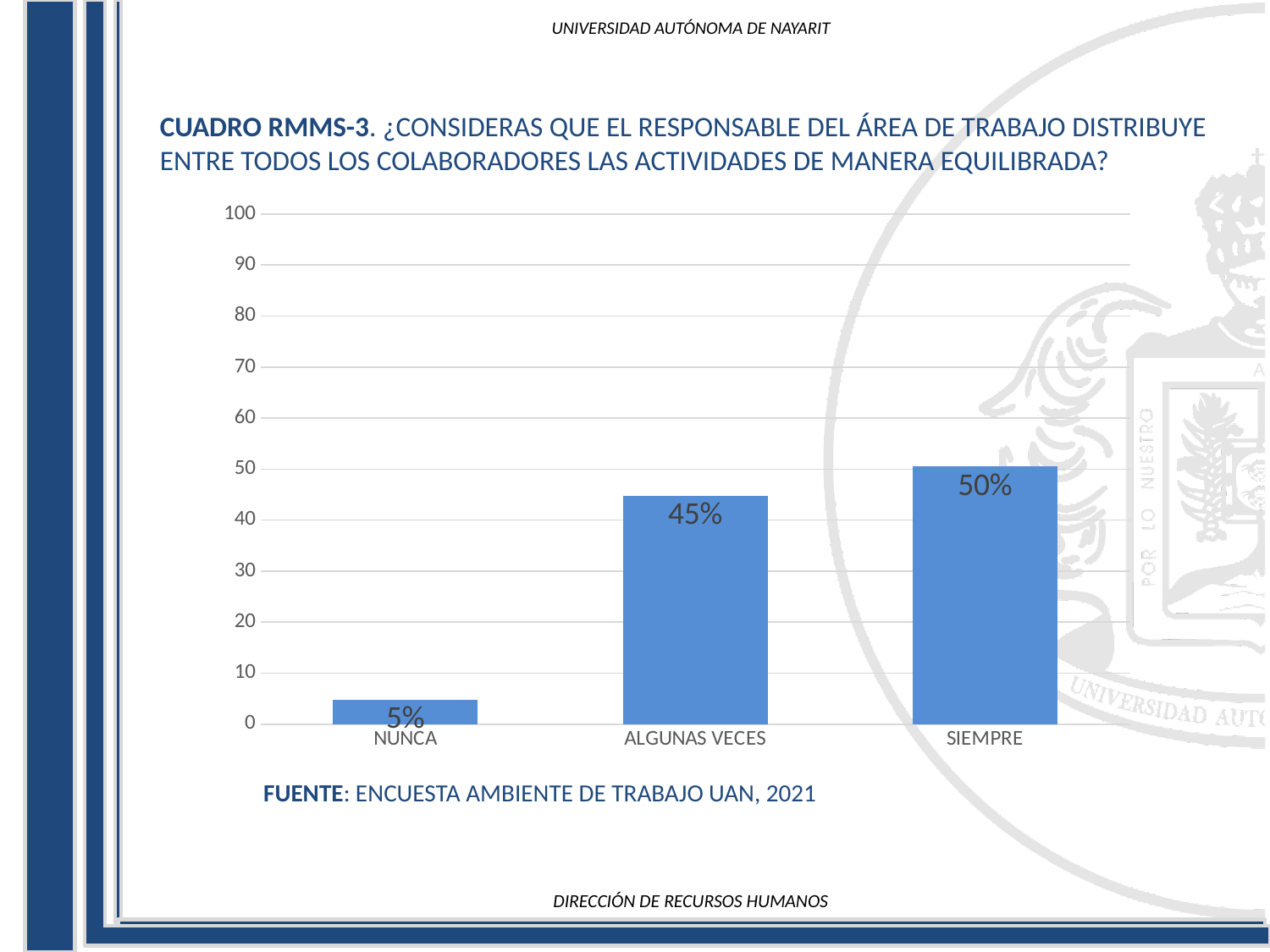
Is the value for ALGUNAS VECES greater or less than 40? greater How many categories are shown on the x axis? 3 What is the value for NUNCA? 5% What kind of chart is shown on the slide? bar chart What is the difference between the values for ALGUNAS VECES and NUNCA? 40% What is the value for SIEMPRE? 50% Which is larger, the value for NUNCA or the value for ALGUNAS VECES? ALGUNAS VECES What is the value for ALGUNAS VECES? 45% Do the values rise or fall from NUNCA to SIEMPRE along the x axis? rise Which category has the highest value? SIEMPRE Which category has the lowest value? NUNCA What is the difference between the values for SIEMPRE and ALGUNAS VECES? 5%